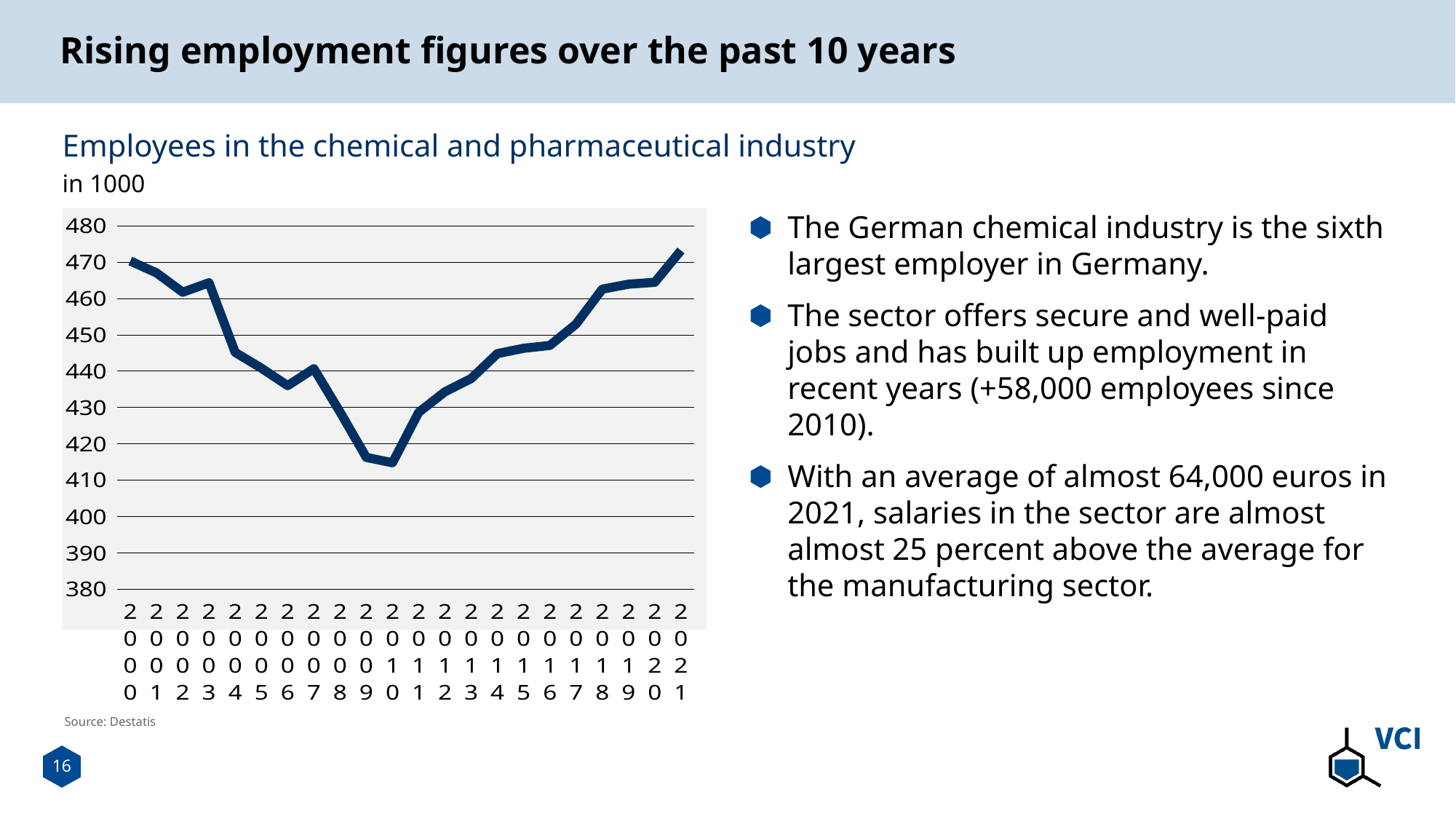
Is the value for 2021 greater or less than 470? greater What is the title of the chart? Employees in the chemical and pharmaceutical industry Is the value for 2006 greater or less than 440? less How many years are plotted on the x axis of the chart? 22 What kind of chart is shown on the slide? line chart In what unit are the values on the chart given? in 1000 In which year does the line reach its lowest point? 2010 Which year has the higher value, 2003 or 2004? 2003 Is the value for 2010 greater or less than 420? less Do the values rise or fall from 2010 to 2021? rise In which year does the line reach its highest point? 2021